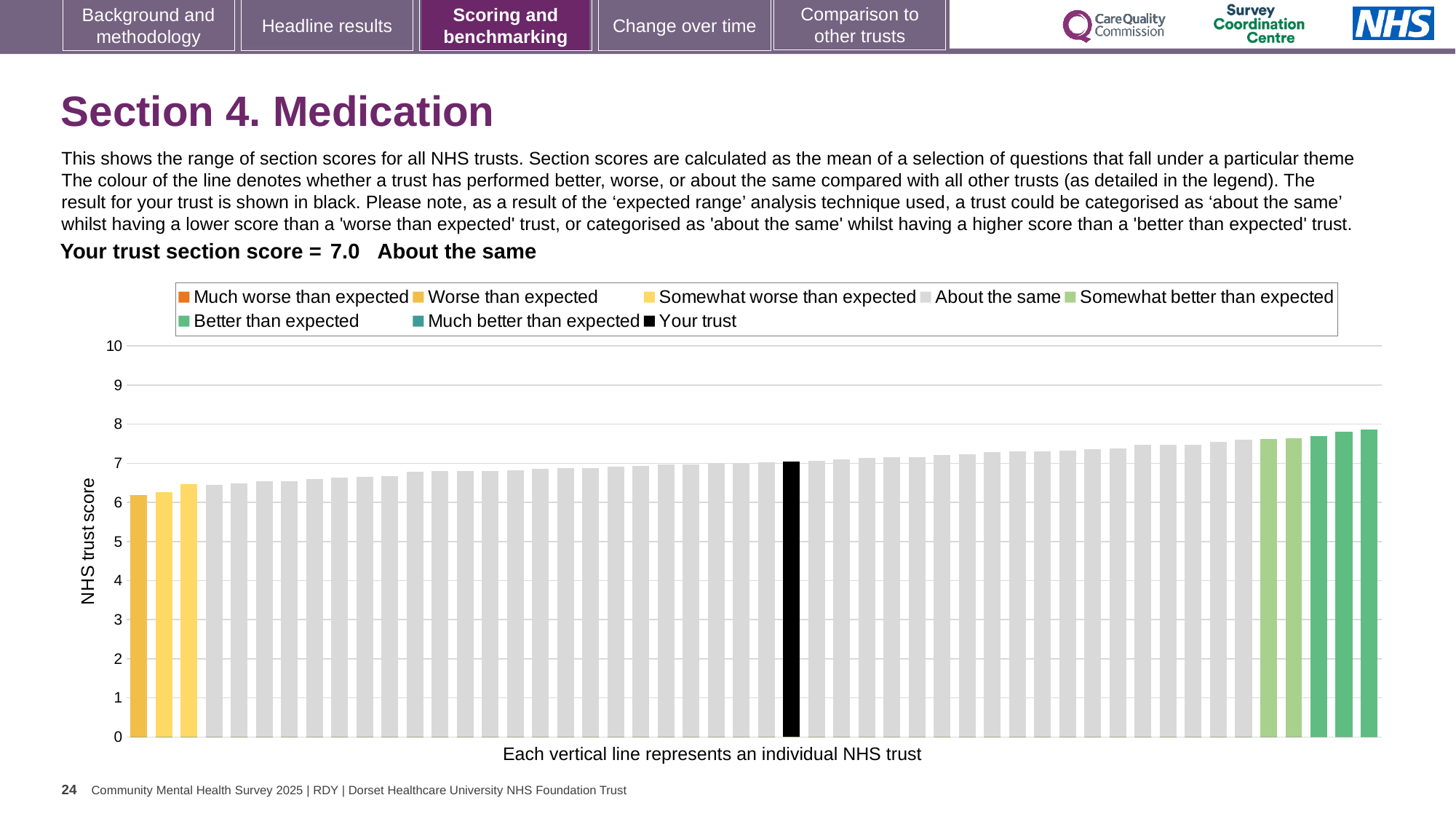
Is the value of the rightmost (highest) bar greater or less than 8? less Do the bar values rise or fall from left to right along the x axis? rise Which is larger: the black bar for your trust or the leftmost bar? the black bar for your trust What is the section score for your trust shown on the slide? 7.0 How many entries does the chart legend list? 8 What kind of chart is shown on the slide? bar chart Is the value of the rightmost bar greater or less than 7? greater Is the value of the leftmost (lowest) bar greater or less than 7? less What colour is the bar representing your trust? black How many bars are coloured in the 'Worse than expected' colour (darker yellow)? 1 What is the label on the vertical axis of the chart? NHS trust score Which category is your trust placed in for the Medication section? About the same